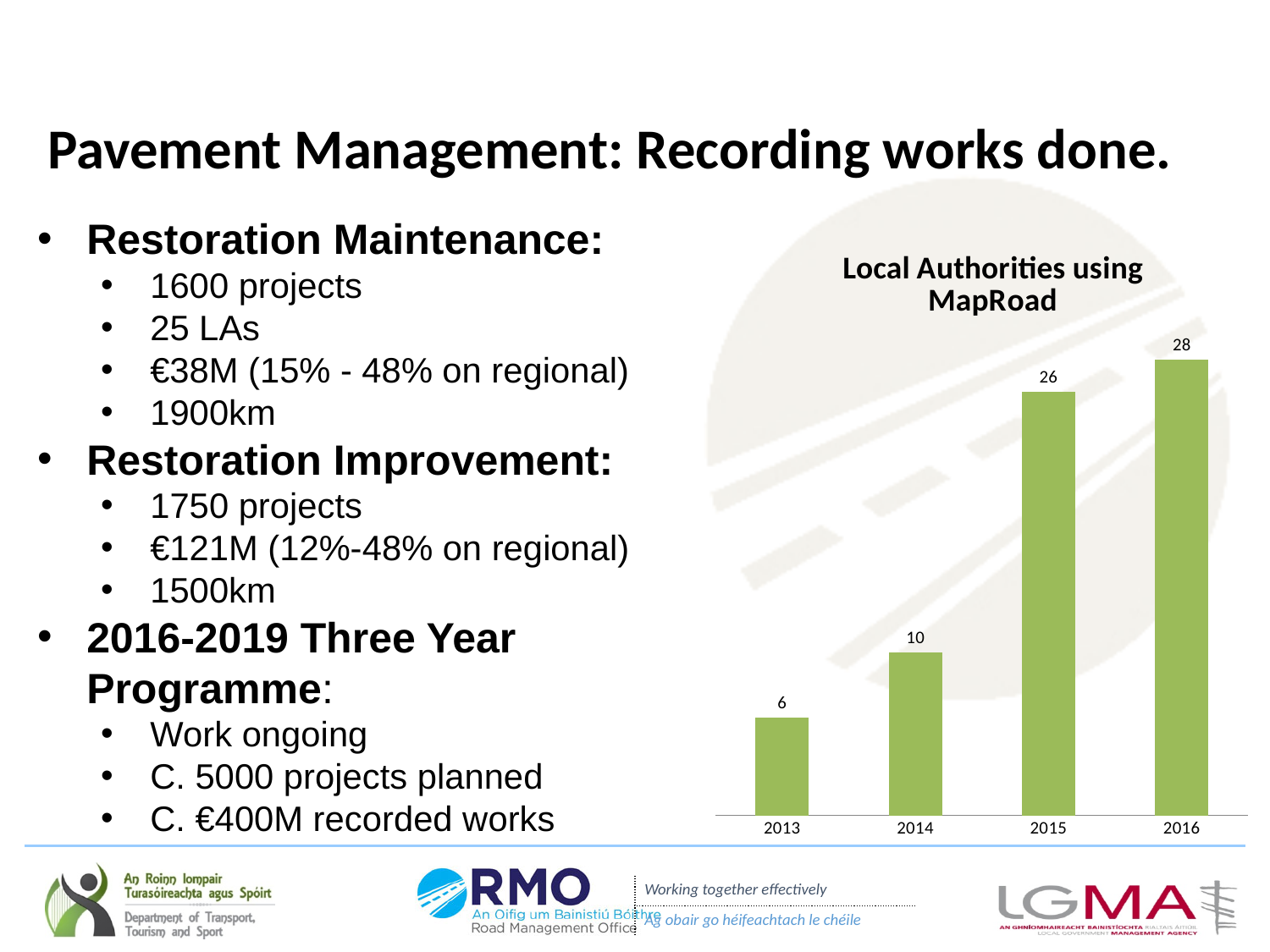
How many years are shown on the x axis of the chart? 4 How many local authorities were using MapRoad in 2015? 26 How many local authorities were using MapRoad in 2016? 28 How many local authorities were using MapRoad in 2013? 6 Which year had more local authorities using MapRoad, 2013 or 2014? 2014 How many local authorities were using MapRoad in 2014? 10 What type of chart is shown on the slide? bar chart Does the number of local authorities using MapRoad rise or fall from 2013 to 2016? rise Which year has the highest number of local authorities using MapRoad? 2016 What is the title of the chart? Local Authorities using MapRoad Which year has the lowest number of local authorities using MapRoad? 2013 What is the difference between the number of local authorities using MapRoad in 2015 and in 2014? 16